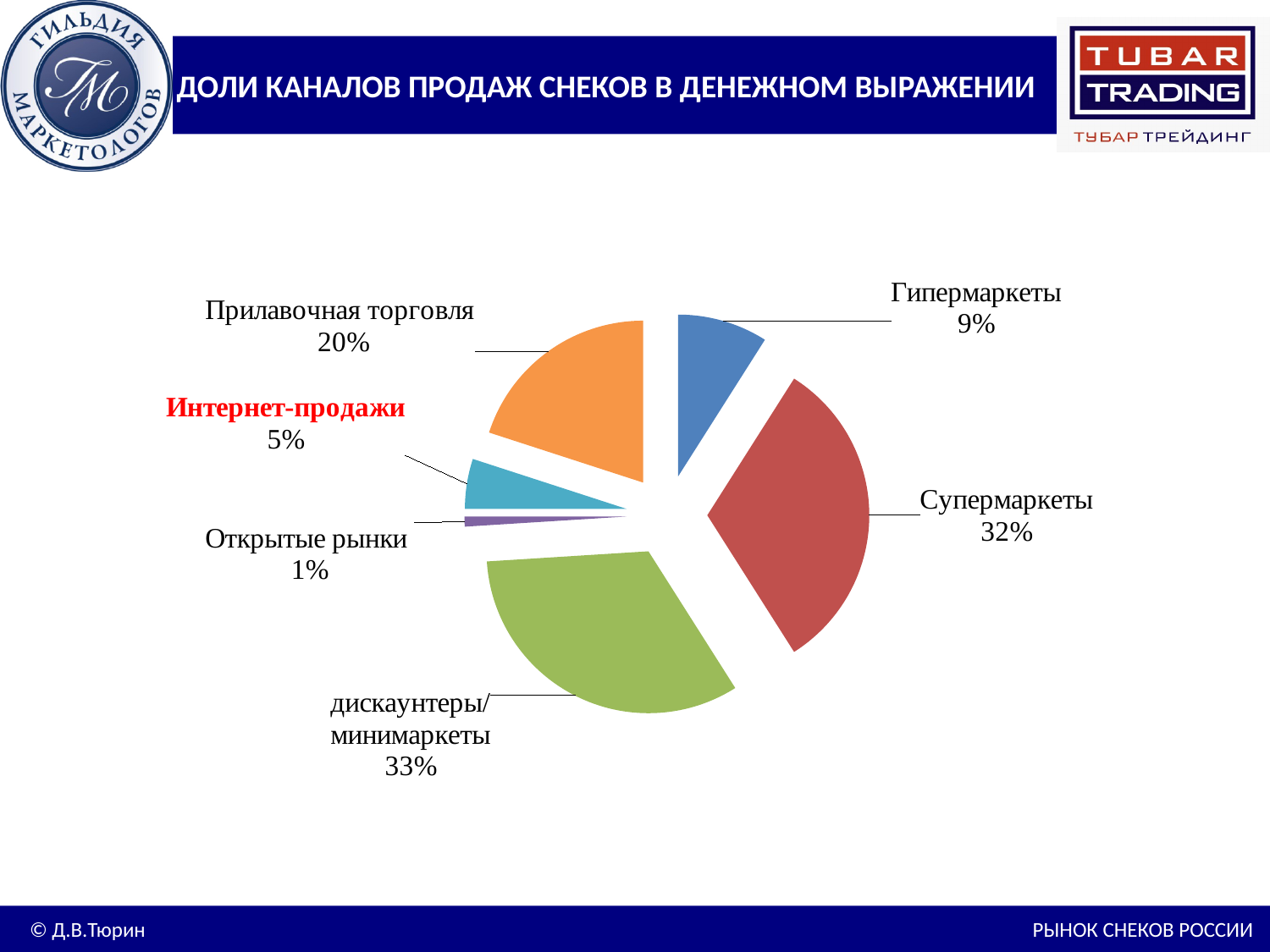
What is the title of the slide containing the pie chart? ДОЛИ КАНАЛОВ ПРОДАЖ СНЕКОВ В ДЕНЕЖНОМ ВЫРАЖЕНИИ What is the difference between the shares of Прилавочная торговля and Гипермаркеты? 11% How many slices does the pie chart have? 6 What share is shown for Открытые рынки? 1% What is the value shown for Гипермаркеты? 9% What share of snack sales does the Супермаркеты slice represent? 32% What percentage is shown for Интернет-продажи? 5% Which sales channel has the largest share in the pie chart? дискаунтеры/минимаркеты What is the value for Прилавочная торговля? 20% Which is larger, the share for Супермаркеты or the share for Прилавочная торговля? Супермаркеты What kind of chart is shown on the slide? pie chart Which sales channel has the smallest share in the pie chart? Открытые рынки